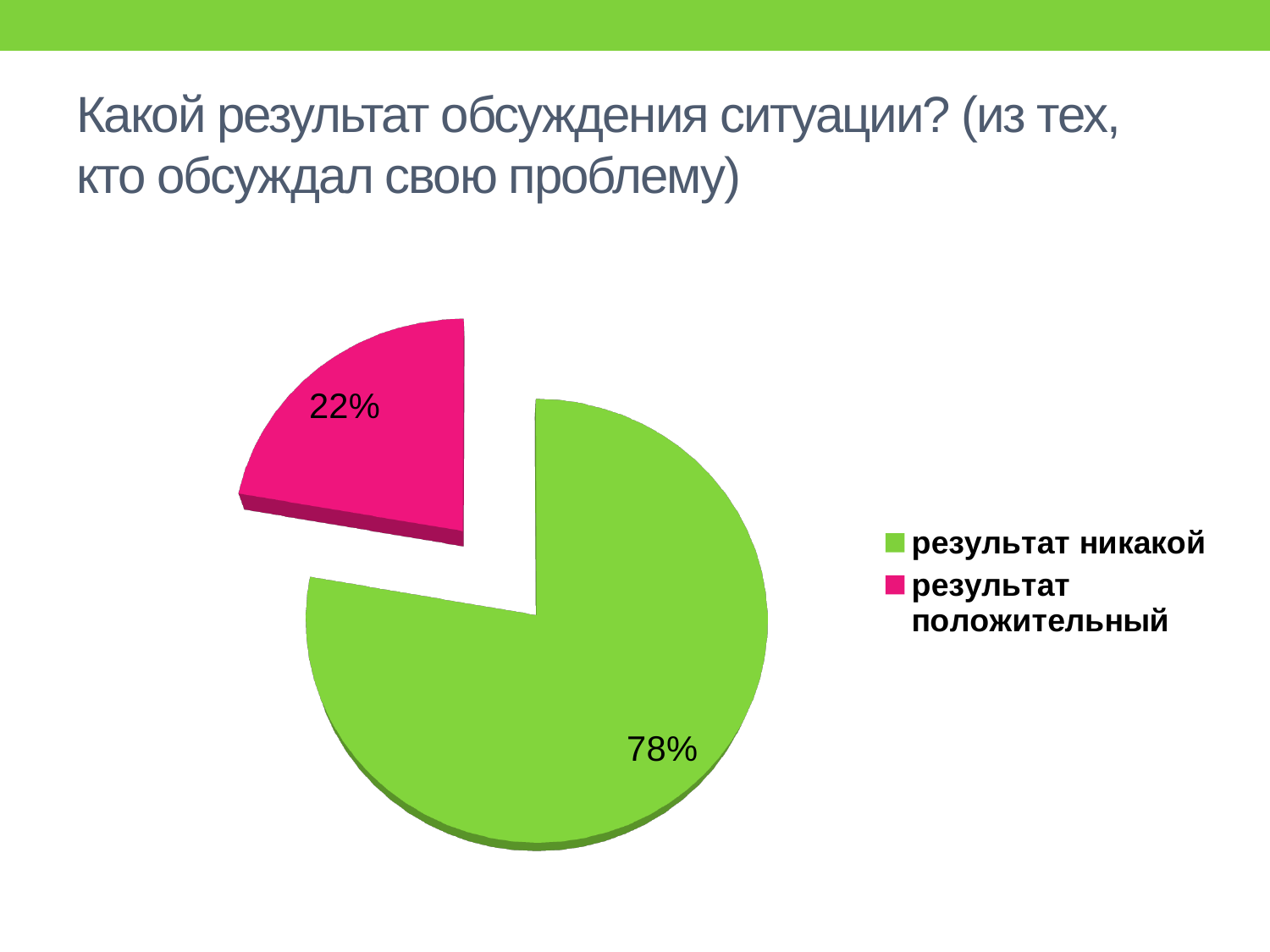
What share of the pie does "результат никакой" take? 78% What is the difference in percentage points between "результат никакой" and "результат положительный"? 56 How many entries does the legend list? 2 What colour is the slice for "результат никакой"? green Which category has the smallest slice of the pie? результат положительный Which category has the largest slice of the pie? результат никакой What kind of chart is shown on the slide? pie chart What share of the pie does "результат положительный" take? 22% What colour is the slice for "результат положительный"? pink How many slices does the pie chart have? 2 Which is larger: the slice for "результат никакой" or the slice for "результат положительный"? результат никакой